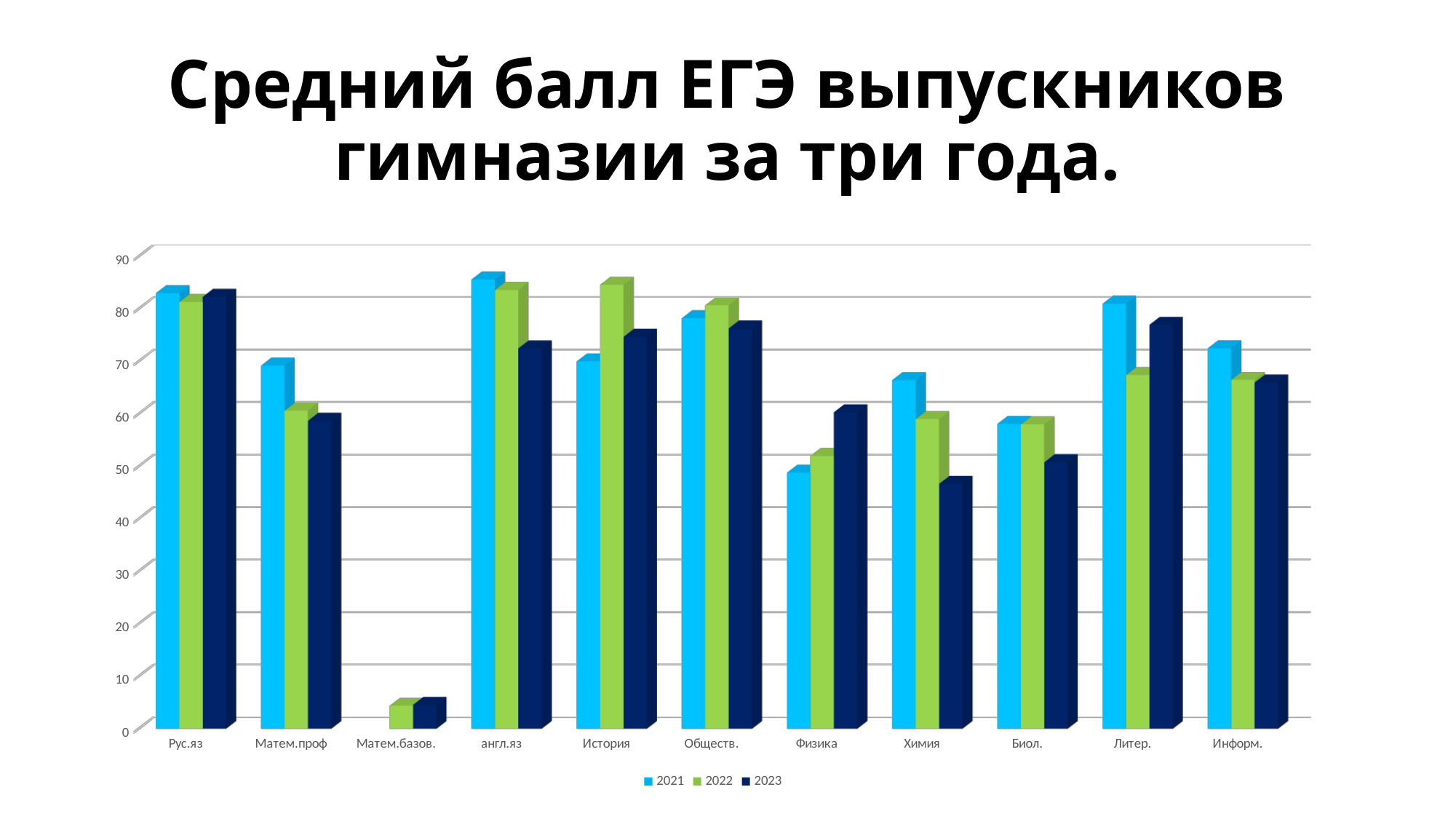
Is the value for Информ. in 2021 greater or less than 70? greater Which series is shown in light blue in the legend? 2021 How many series does the legend list? 3 For Физика, which year has the larger value, 2021 or 2023? 2023 For Химия, which year has the larger value, 2021 or 2023? 2021 What kind of chart is shown on the slide? bar chart How many subject categories are shown on the x axis? 11 Is the value for Химия in 2023 greater or less than 50? less Which subject has the lowest value for 2023? Матем.базов. Is the value for Рус.яз in 2021 greater or less than 80? greater For Литер., which year has the larger value, 2021 or 2022? 2021